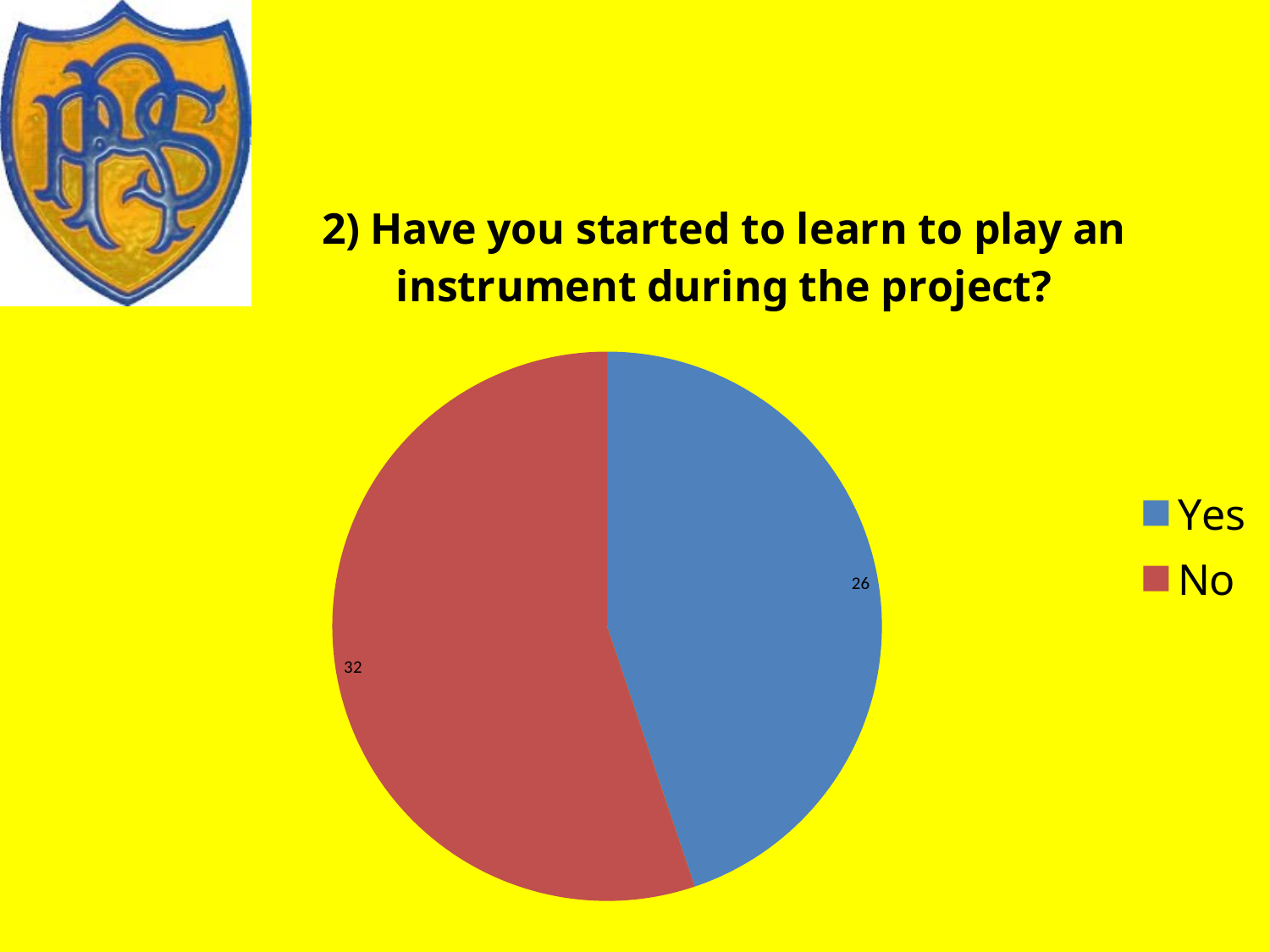
Which response has the larger slice of the pie? No Which response has the smaller slice of the pie? Yes What colour is the Yes slice? blue What is the difference between the number of No and Yes responses? 6 How many respondents answered No? 32 Is the value for Yes larger or smaller than the value for No? smaller What is the total number of responses shown in the pie chart? 58 How many respondents answered Yes? 26 How many entries does the legend list? 2 What is the title of the chart? 2) Have you started to learn to play an instrument during the project? What kind of chart is shown on the slide? pie chart How many slices does the pie chart have? 2